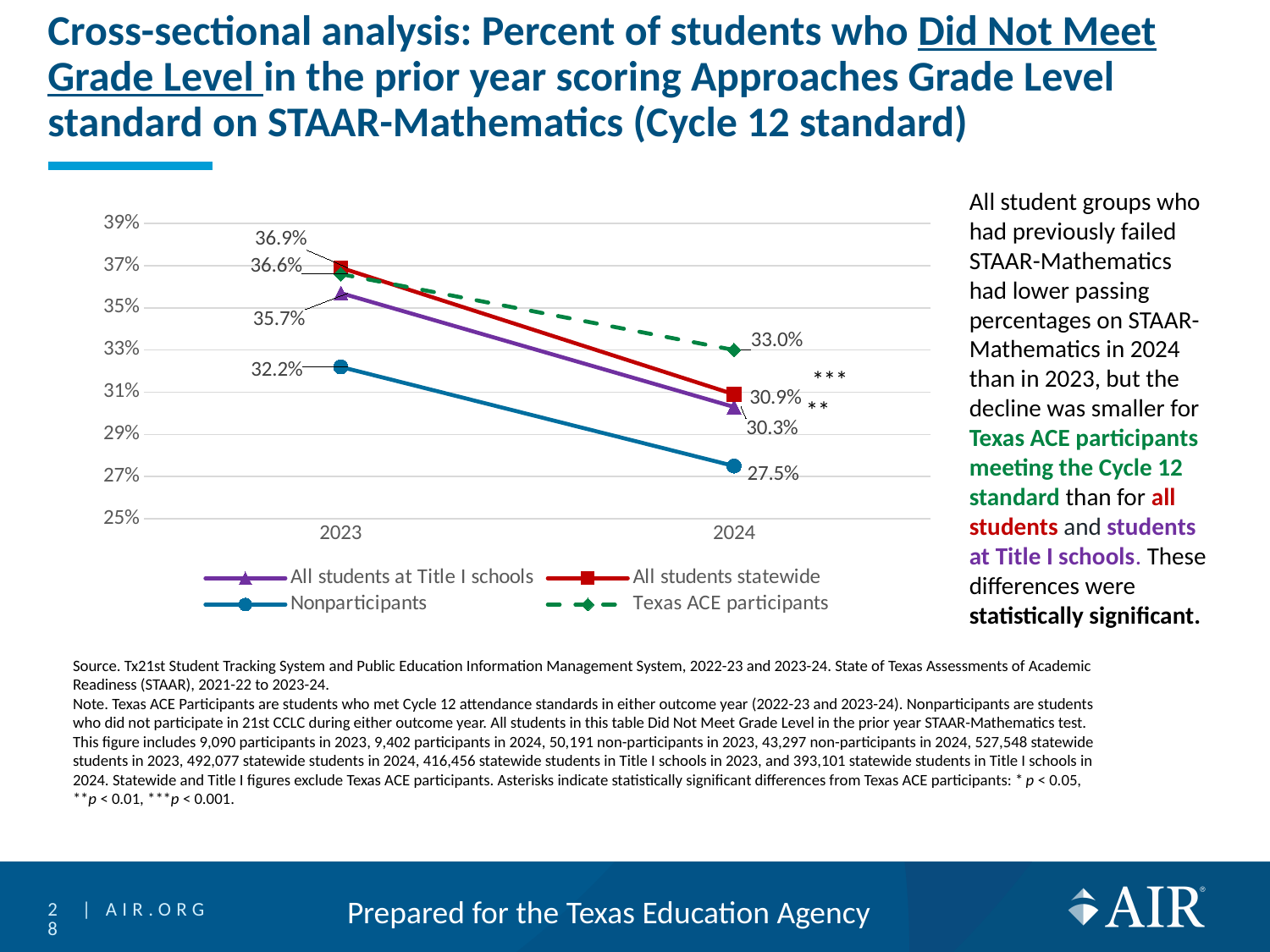
By how many percentage points did the value for Texas ACE participants fall from 2023 to 2024? 3.6 percentage points What is the value for All students at Title I schools in 2024? 30.3% Do the values for all student groups rise or fall from 2023 to 2024? Fall Which student group has the highest value in 2024? Texas ACE participants What kind of chart is shown on the slide? Line chart What is the value for All students statewide in 2023? 36.9% In 2024, which is larger: the value for All students statewide or the value for All students at Title I schools? All students statewide Which student group has the lowest value in 2023? Nonparticipants By how many percentage points did the value for Nonparticipants fall from 2023 to 2024? 4.7 percentage points What is the value for Texas ACE participants in 2024? 33.0% What is the value for Nonparticipants in 2023? 32.2% How many series does the legend list? 4